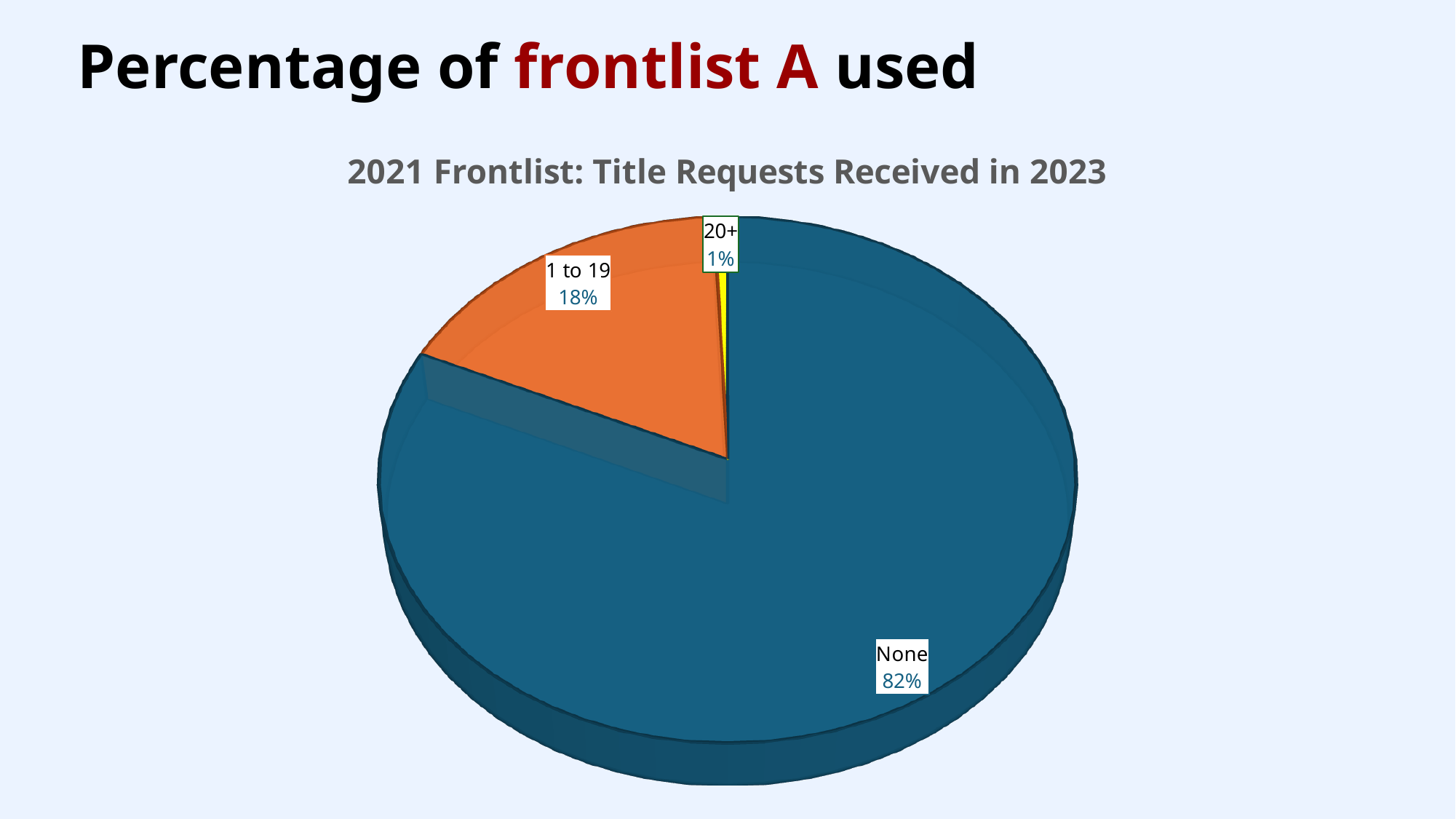
What percentage of the pie is the "None" slice? 82% What kind of chart is shown on the slide? Pie chart What is the difference in percentage points between the "None" slice and the "1 to 19" slice? 64 What percentage of the pie is the "1 to 19" slice? 18% How many slices does the pie chart have? 3 What percentage of the pie is the "20+" slice? 1% What is the difference in percentage points between the "1 to 19" slice and the "20+" slice? 17 What colour is the "1 to 19" slice? Orange Which slice is larger, "1 to 19" or "20+"? 1 to 19 What is the title of the chart? 2021 Frontlist: Title Requests Received in 2023 Which category has the largest share of the pie? None Which category has the smallest share of the pie? 20+